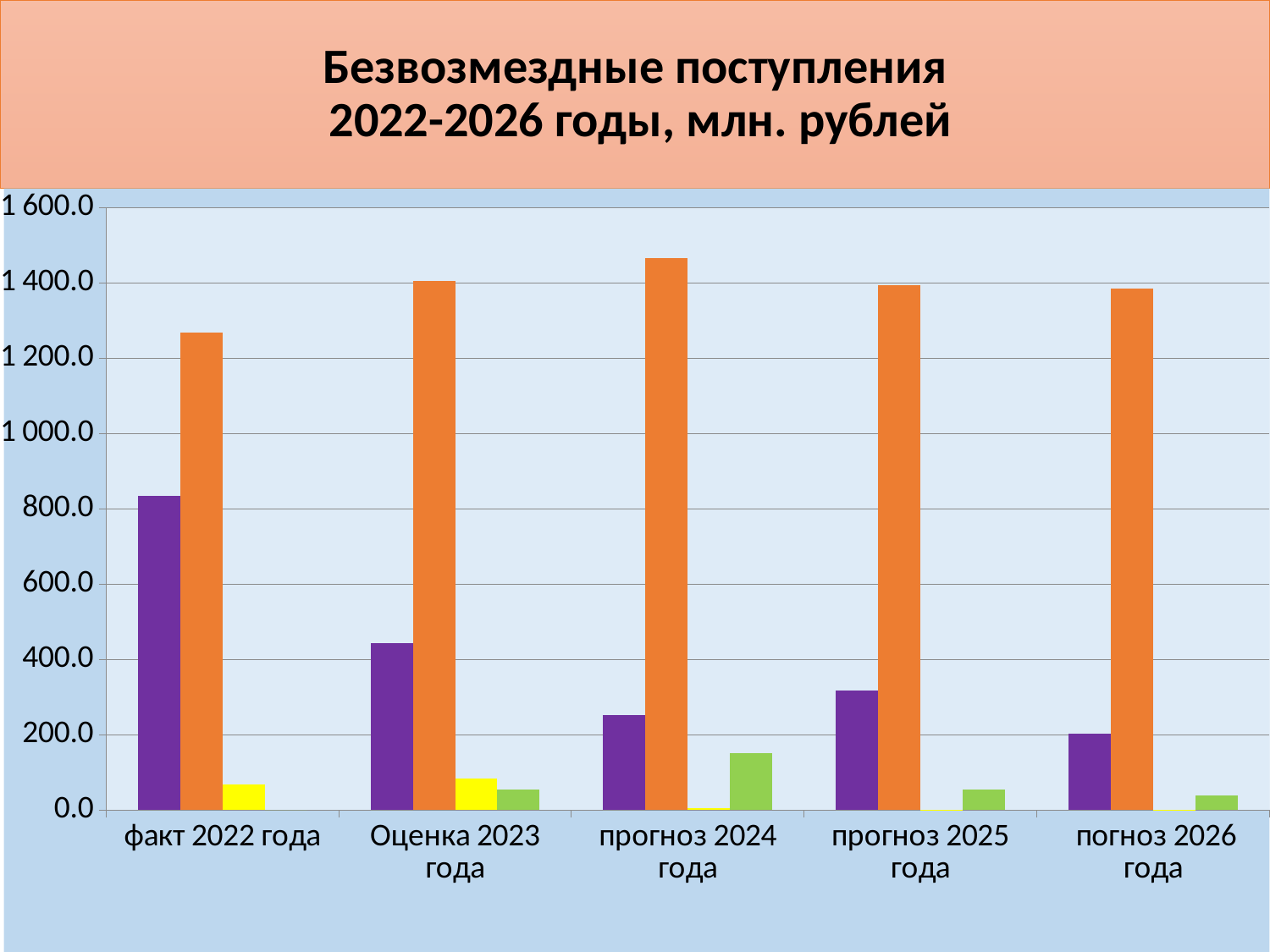
Is the purple bar for факт 2022 года greater or less than 800.0? greater In which category is the purple bar the tallest? факт 2022 года How many categories are shown along the x axis? 5 Which is larger, the purple bar for факт 2022 года or the purple bar for Оценка 2023 года? факт 2022 года In which category is the orange bar the shortest? факт 2022 года In which category is the orange bar the tallest? прогноз 2024 года What is the title of the chart? Безвозмездные поступления 2022-2026 годы, млн. рублей Is the orange bar for прогноз 2024 года greater or less than 1 400.0? greater Is the orange bar for факт 2022 года greater or less than 1 200.0? greater What kind of chart is shown on the slide? bar chart Which is larger for Оценка 2023 года, the purple bar or the orange bar? the orange bar